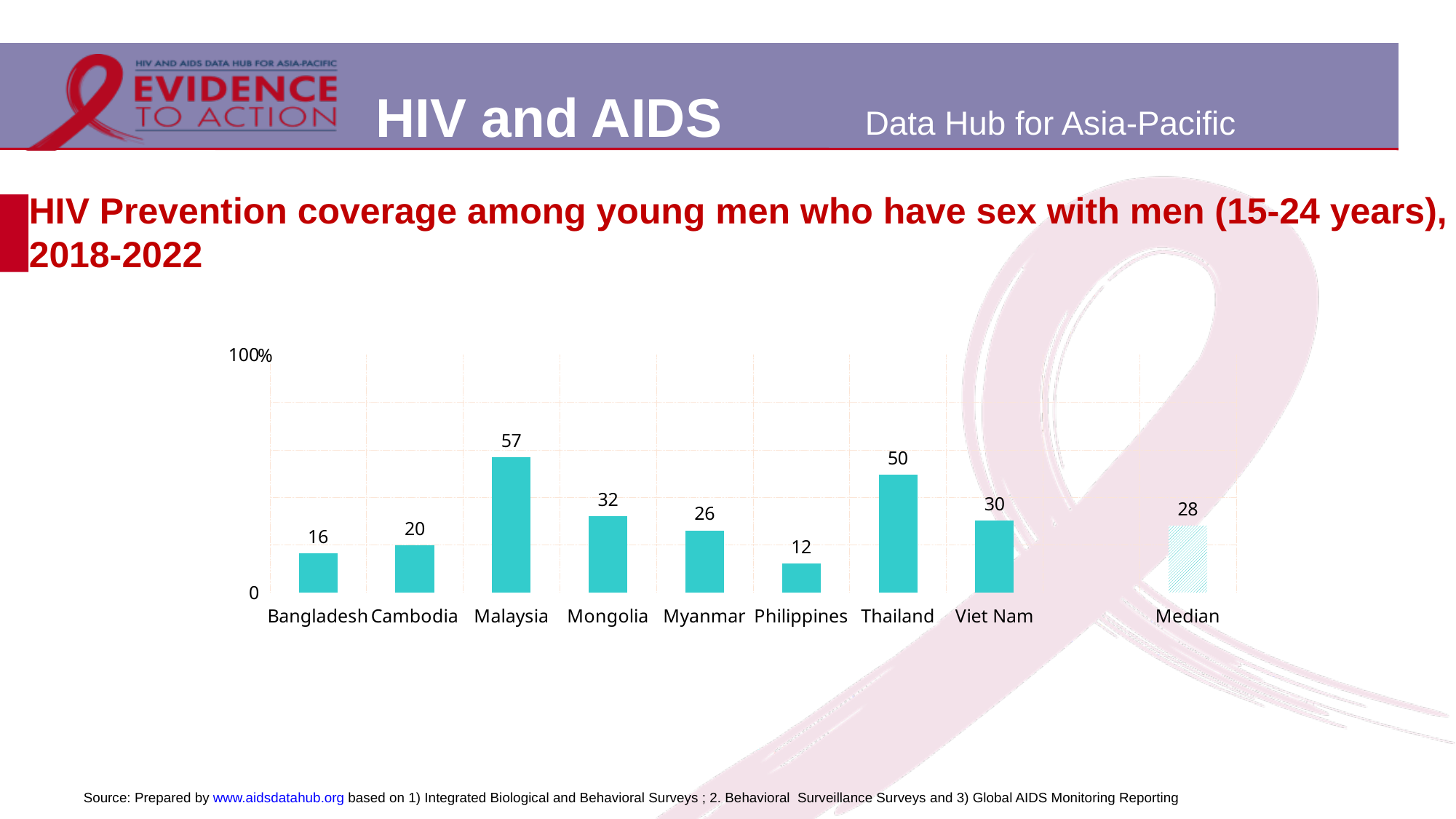
Which has a higher value, Cambodia or Bangladesh? Cambodia What is the difference between the values for Malaysia and Thailand? 7 What is the Median value shown on the chart? 28 What is the difference between the values for Mongolia and Bangladesh? 16 What type of chart is shown on the slide? Bar chart How many countries (excluding the Median) are shown on the chart? 8 Which has a higher value, Viet Nam or Myanmar? Viet Nam What is the HIV prevention coverage value shown for Malaysia? 57 Which country has the highest HIV prevention coverage on the chart? Malaysia Which country has the lowest HIV prevention coverage on the chart? Philippines What is the value shown for the Philippines? 12 What is the maximum value labelled on the vertical axis of the chart? 100%